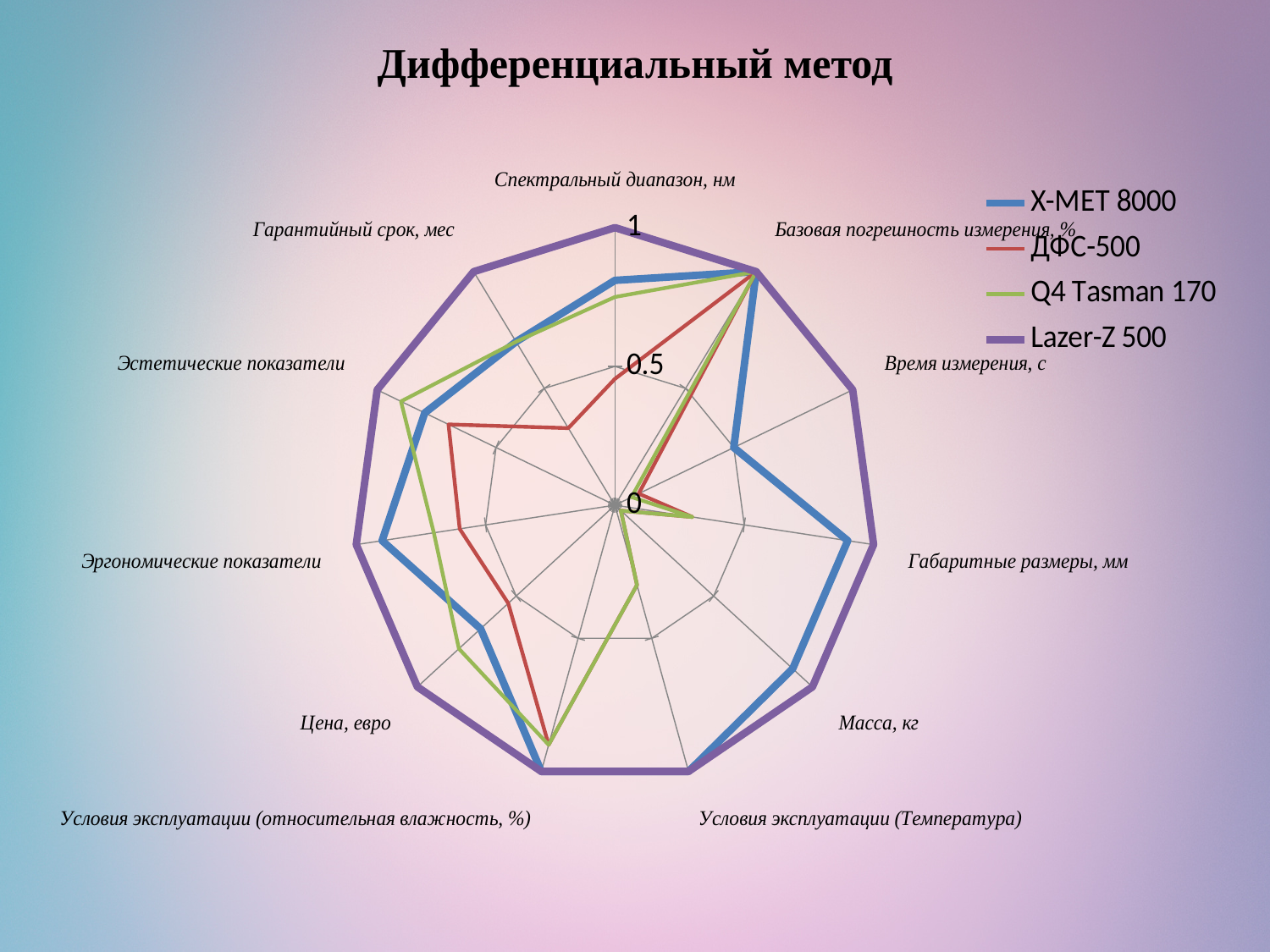
For Спектральный диапазон, нм, which is larger: the value of X-MET 8000 or the value of ДФС-500? X-MET 8000 What is the title of the slide containing the chart? Дифференциальный метод How many series does the legend list? 4 Which series has the highest value for Габаритные размеры, мм? Lazer-Z 500 Is the value of ДФС-500 for Время измерения, с greater or less than 0.5? less Is the value of X-MET 8000 for Габаритные размеры, мм greater or less than 0.5? greater How many category axes does the radar chart have? 11 What kind of chart is shown on the slide? Radar chart What is the value of Lazer-Z 500 for Цена, евро? 1 Is the value of Q4 Tasman 170 for Цена, евро greater or less than 0.5? greater What is the value of Lazer-Z 500 for Спектральный диапазон, нм? 1